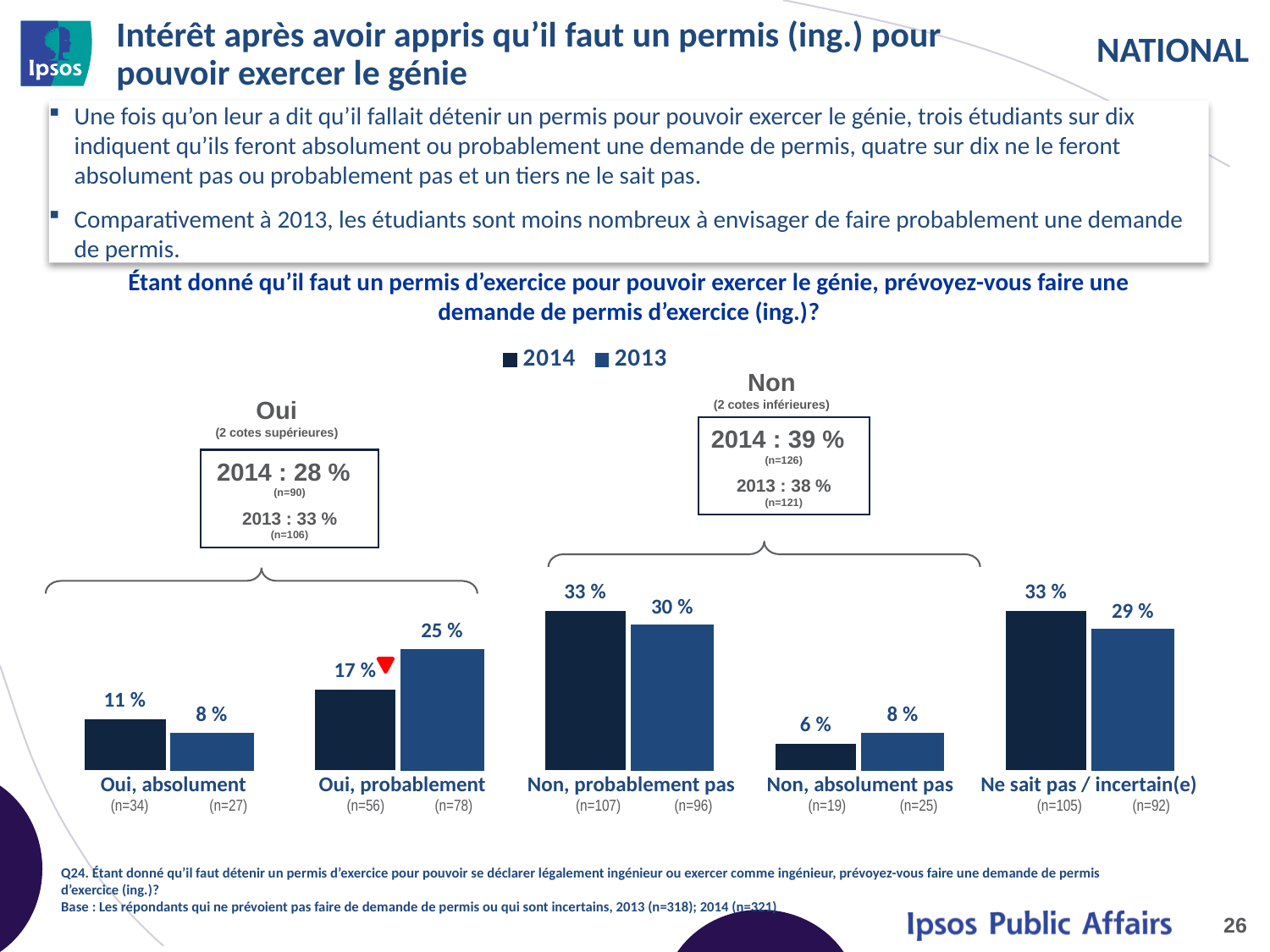
How many categories are shown on the x axis of the chart? 5 For "Non, absolument pas", which year has the larger value, 2014 or 2013? 2013 What is the difference between the 2014 and 2013 values for "Oui, absolument"? 3 % Which category has the highest 2013 value? Non, probablement pas How many series does the chart legend list? 2 What is the 2013 value for "Non, probablement pas"? 30 % What is the difference between the 2013 and 2014 values for "Oui, probablement"? 8 % What kind of chart is shown on the slide? Bar chart Which category has the lowest 2014 value? Non, absolument pas What is the 2013 value for "Ne sait pas / incertain(e)"? 29 % For "Ne sait pas / incertain(e)", which year has the larger value, 2014 or 2013? 2014 What is the 2014 value for "Oui, probablement"? 17 %